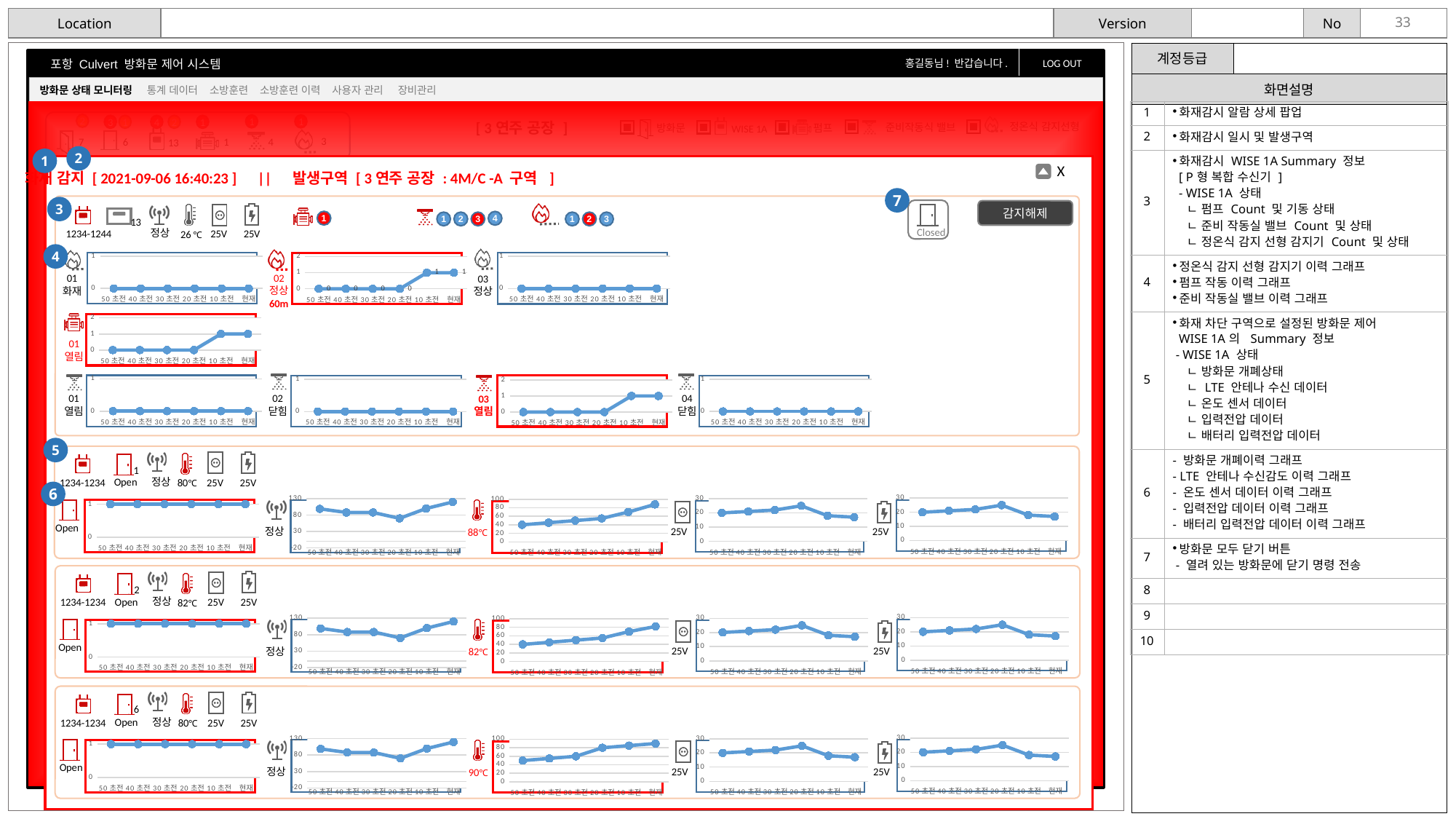
What kind of chart is used for the 02 정상 detector history in the top panel (red-bordered chart)? line chart In the 02 정상 chart in the top panel, what is the value at 50 초전? 0 In the 01 화재 chart at the top left of the top panel, do the values rise, fall, or stay flat across the x axis? stay flat What is the highest y-axis tick shown on the 02 정상 chart in the top panel? 2 In the 02 정상 chart in the top panel, what is the value at 현재? 1 In the 01 열림 pump chart in the top panel, do the values rise or fall from 50 초전 to 현재? rise What is the label of the last point on the x axis of the history charts? 현재 In the temperature history chart next to the 88℃ reading (door 1 row), is the value at 50 초전 greater or less than 60? less How many time points are plotted along the x axis of the 02 정상 history chart in the top panel? 6 In the 02 정상 chart in the top panel, do the values rise or fall from 50 초전 to 현재? rise In the temperature history chart next to the 88℃ reading (door 1 row), is the value at 현재 greater or less than 60? greater